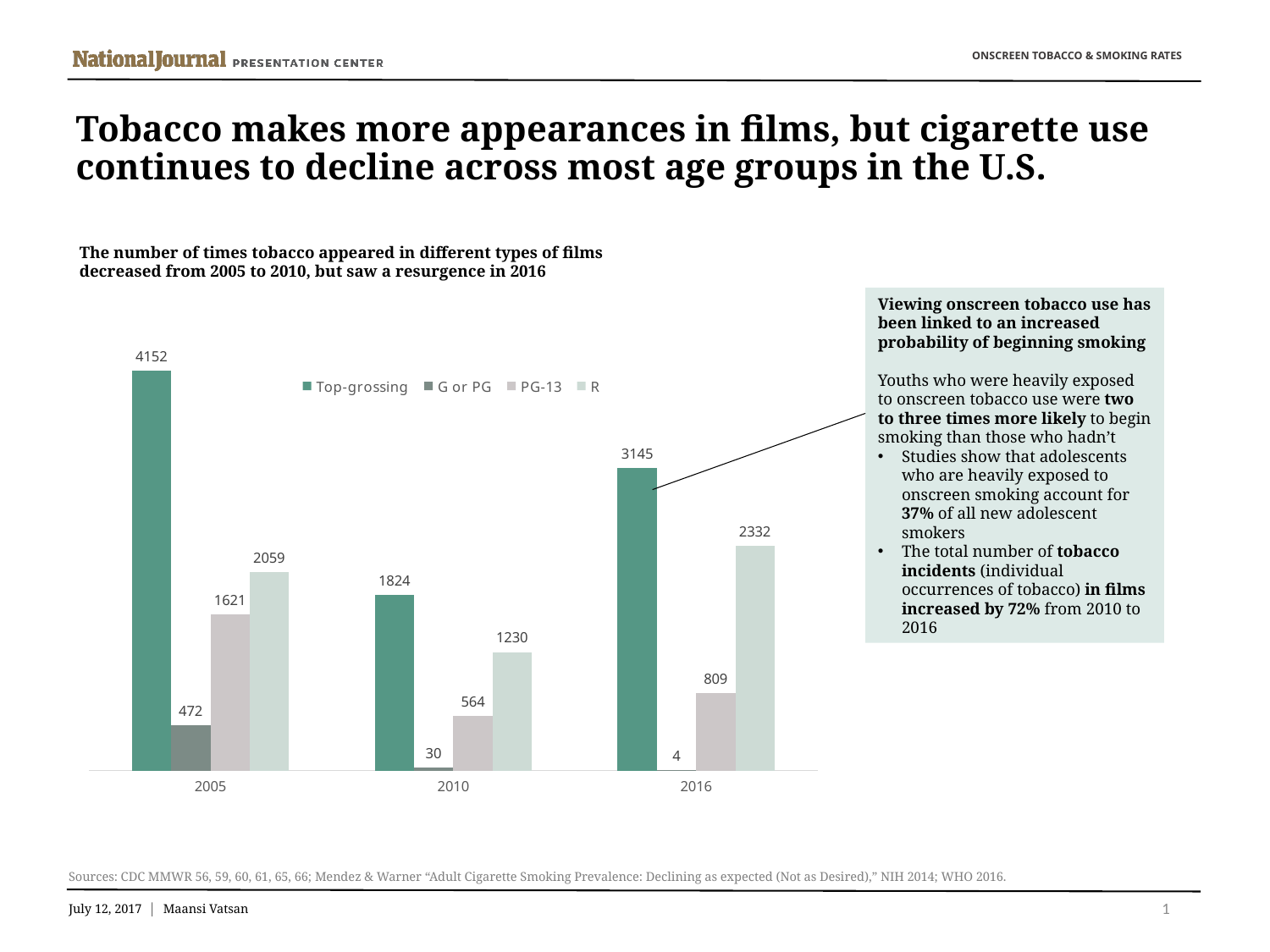
Which is larger, the PG-13 value in 2010 or the PG-13 value in 2016? 2016 What is the value for G or PG films in 2010? 30 Which year has the lowest value for G or PG films? 2016 What kind of chart is shown on the slide? Bar chart How many series does the legend list? 4 What is the value for Top-grossing films in 2005? 4152 What is the difference between the Top-grossing values for 2016 and 2010? 1321 What is the value for PG-13 films in 2005? 1621 What is the value for R-rated films in 2016? 2332 How many years are shown on the x axis? 3 Which year has the highest value for Top-grossing films? 2005 Do the values for R-rated films rise or fall from 2005 to 2010? Fall